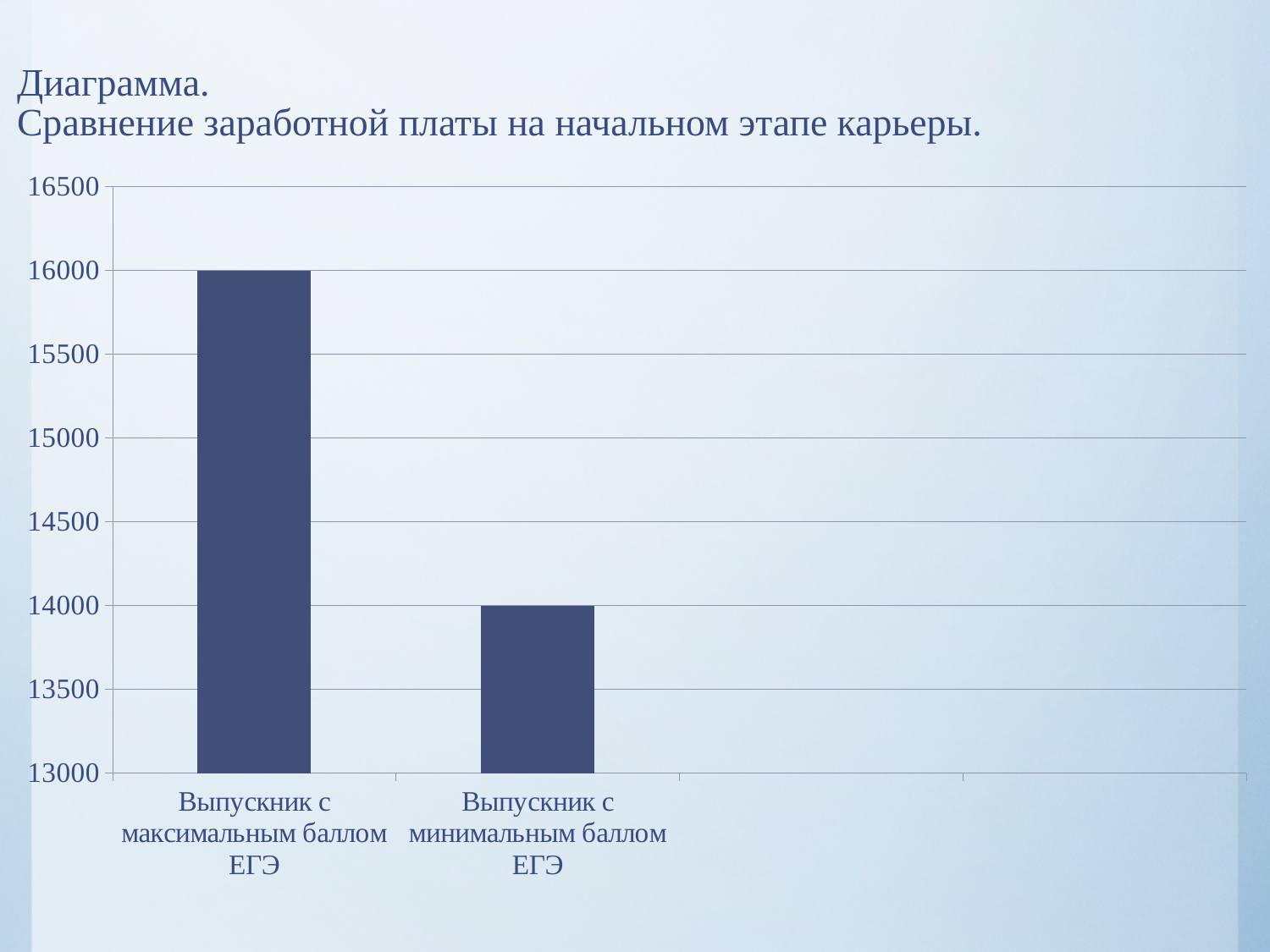
What is the difference between the values for "Выпускник с максимальным баллом ЕГЭ" and "Выпускник с минимальным баллом ЕГЭ"? 2000 Is the value for "Выпускник с минимальным баллом ЕГЭ" greater or less than 15000? less How many categories are plotted in the chart? 2 What kind of chart is shown on the slide? Bar chart Which category has the lowest value? Выпускник с минимальным баллом ЕГЭ Do the values rise or fall from left to right along the x axis? fall Which category has the highest value? Выпускник с максимальным баллом ЕГЭ Which is larger: the value for "Выпускник с максимальным баллом ЕГЭ" or for "Выпускник с минимальным баллом ЕГЭ"? Выпускник с максимальным баллом ЕГЭ Is the value for "Выпускник с максимальным баллом ЕГЭ" greater or less than 15500? greater What is the highest value shown on the vertical axis? 16500 What is the value for "Выпускник с максимальным баллом ЕГЭ"? 16000 What is the value for "Выпускник с минимальным баллом ЕГЭ"? 14000